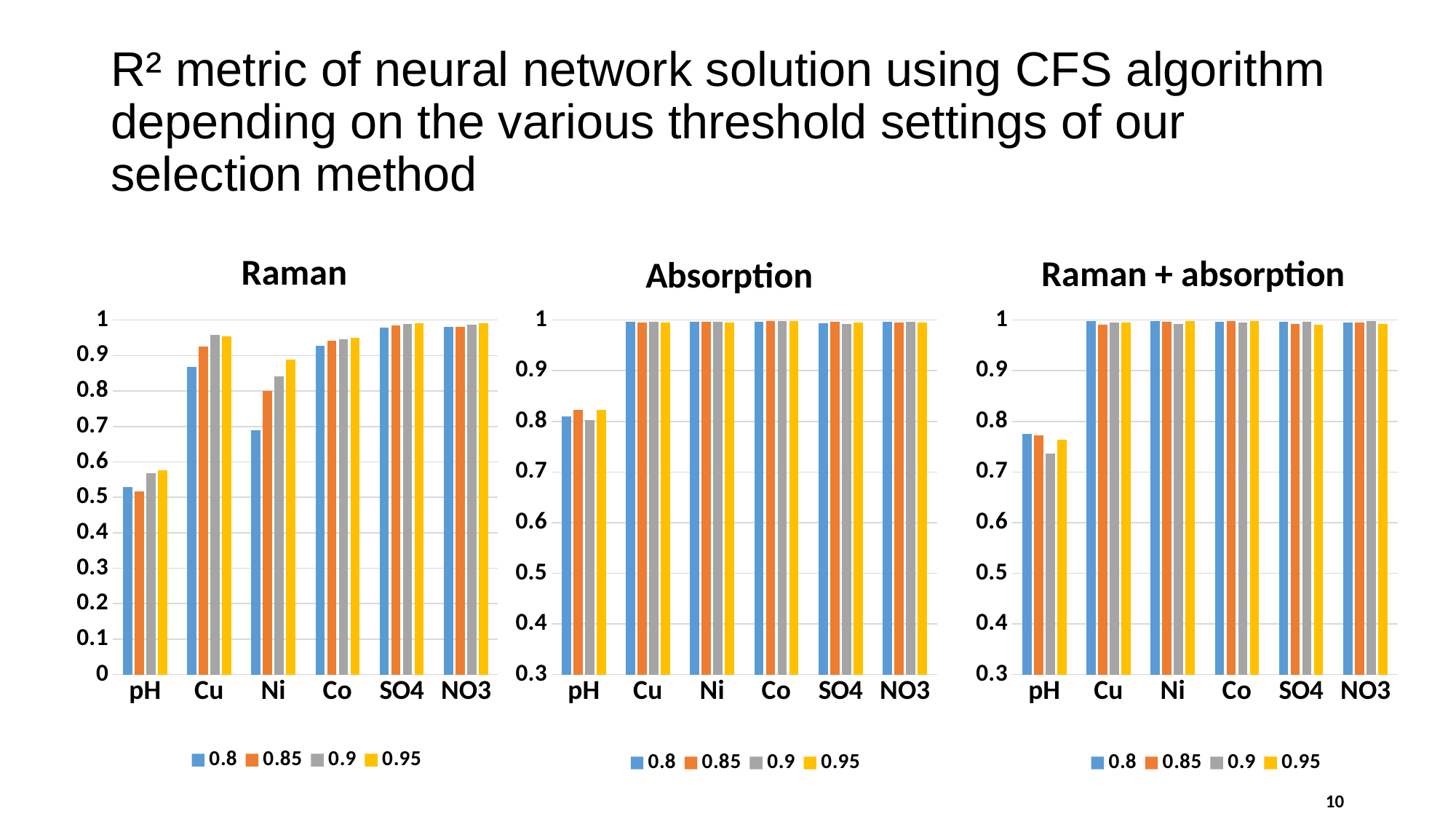
In the Raman chart, which category has the lowest values? pH What kind of chart is the Raman chart? bar chart How many series does the legend of the Absorption chart list? 4 In the Absorption chart, is the value for pH in the 0.8 series greater or less than 0.9? less In the Raman chart, which is larger for Cu: the 0.8 series or the 0.9 series? 0.9 In the Raman chart, is the value for pH in the 0.8 series greater or less than 0.6? less What are the legend entries of the Raman + absorption chart? 0.8, 0.85, 0.9, 0.95 In the Raman chart, which is larger for Ni: the 0.8 series or the 0.95 series? 0.95 How many categories are shown on the x axis of the Raman chart? 6 In the Raman chart, is the value for Ni in the 0.95 series greater or less than 0.8? greater In the Absorption chart, which category has the lowest values? pH